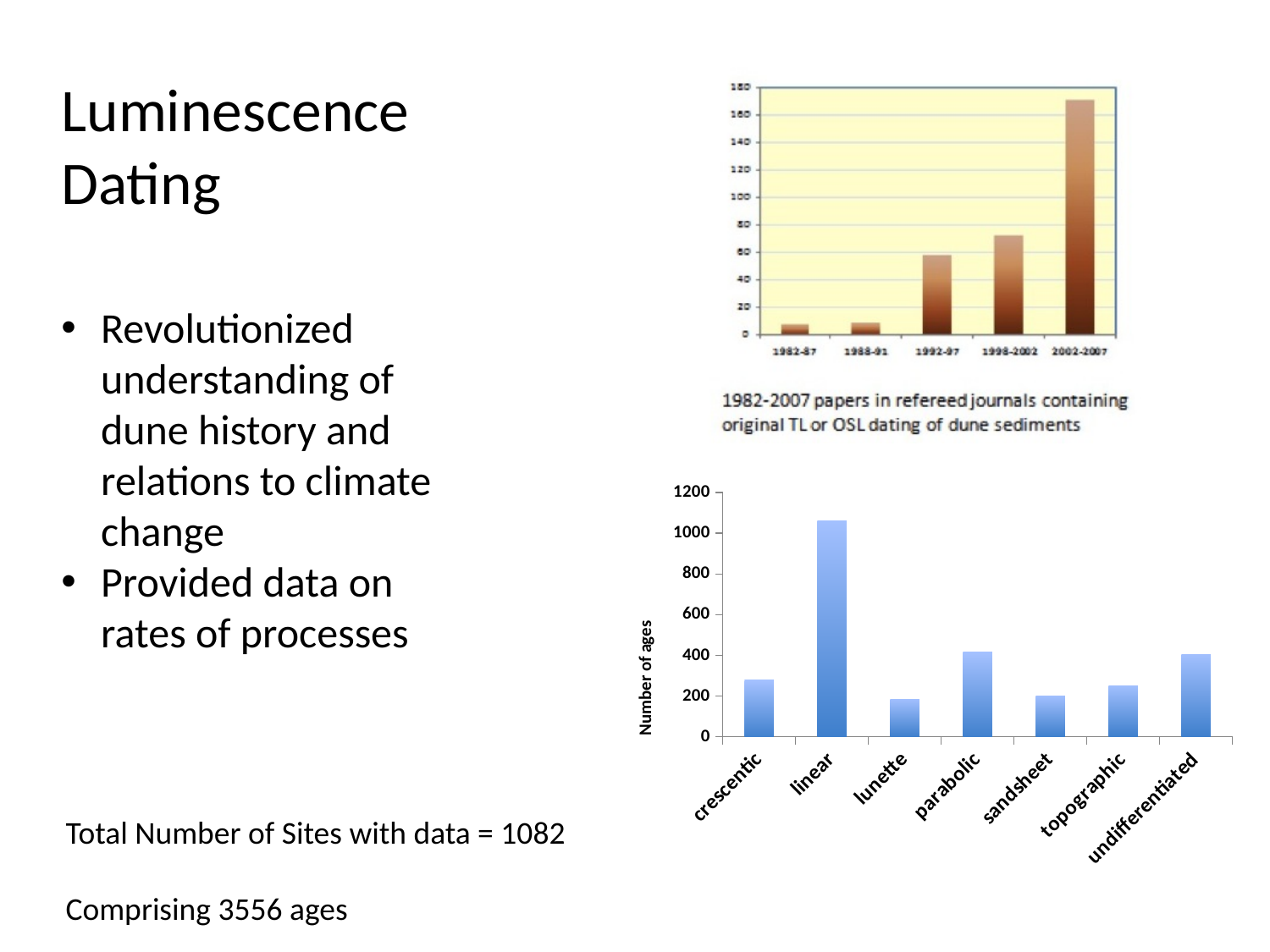
How many periods are shown on the x axis of the top chart? 5 In the bottom chart, is the value for linear greater or less than 1000? greater In the bottom chart, is the value for crescentic greater or less than 200? greater What is the y-axis title of the bottom chart? Number of ages In the top chart, is the value for 2002-2007 greater or less than 160? greater In the top chart, which period has the highest number of papers? 2002-2007 What kind of chart is the bottom chart? bar chart In the top chart, do the values generally rise or fall from 1982-87 to 2002-2007? rise In the bottom chart, which dune type has the highest number of ages? linear In the bottom chart, which is larger, the value for parabolic or the value for topographic? parabolic How many categories are shown on the x axis of the bottom chart? 7